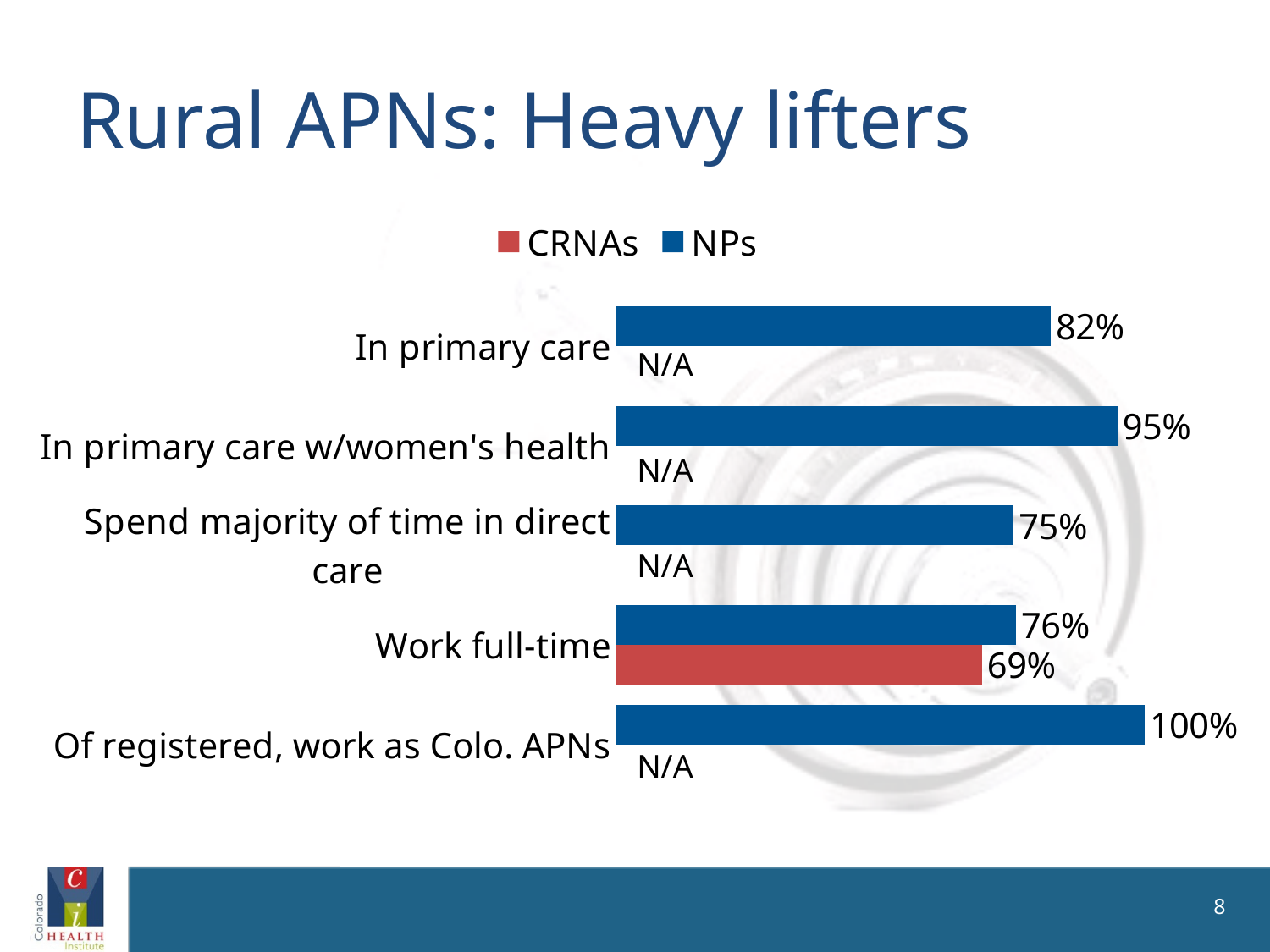
Which category has the lowest NPs value? Spend majority of time in direct care Which category has the highest NPs value? Of registered, work as Colo. APNs What kind of chart is shown on the slide? Bar chart What is the difference between the NPs and CRNAs values for "Work full-time"? 7% For "Work full-time", which is larger: the NPs value or the CRNAs value? NPs What is shown for CRNAs in the "Spend majority of time in direct care" category? N/A How many series does the legend list? 2 What is the CRNAs value for "Work full-time"? 69% What is the NPs value for "In primary care"? 82% How many categories are shown on the chart? 5 What is the NPs value for "In primary care w/women's health"? 95% What is the NPs value for "Of registered, work as Colo. APNs"? 100%